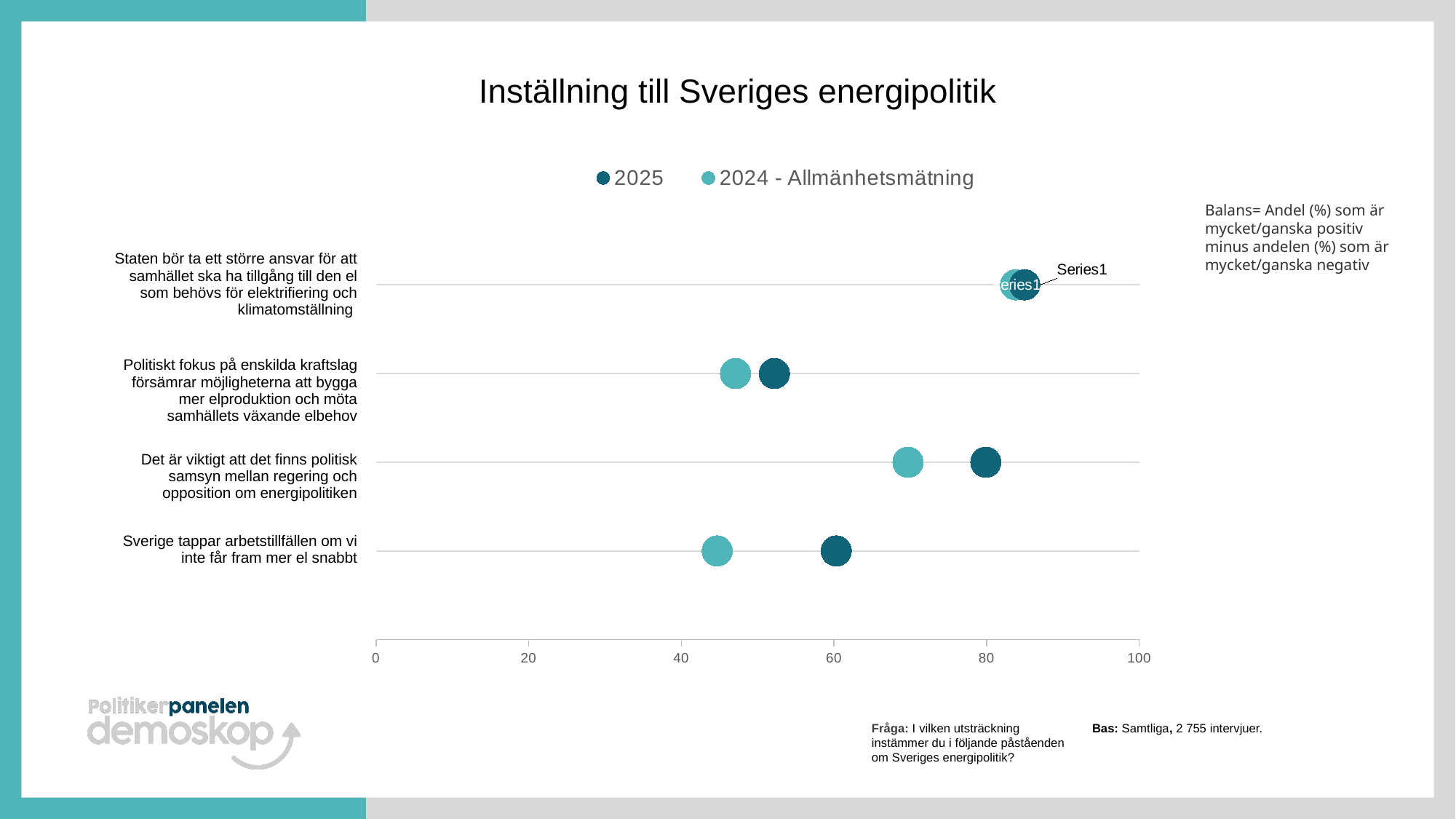
Which statement has the lowest value for the 2025 series? Politiskt fokus på enskilda kraftslag försämrar möjligheterna att bygga mer elproduktion och möta samhällets växande elbehov For 'Sverige tappar arbetstillfällen om vi inte får fram mer el snabbt', which series has the larger value, 2025 or 2024 - Allmänhetsmätning? 2025 How many series does the chart legend list? 2 For 'Det är viktigt att det finns politisk samsyn mellan regering och opposition om energipolitiken', which series has the larger value, 2025 or 2024 - Allmänhetsmätning? 2025 What is the title of the chart? Inställning till Sveriges energipolitik Is the 2025 value for 'Det är viktigt att det finns politisk samsyn mellan regering och opposition om energipolitiken' greater or less than 60? greater How many statements (categories) are plotted on the chart? 4 Is the 2024 - Allmänhetsmätning value for 'Sverige tappar arbetstillfällen om vi inte får fram mer el snabbt' greater or less than 60? less Is the 2025 value for 'Staten bör ta ett större ansvar för att samhället ska ha tillgång till den el som behövs för elektrifiering och klimatomställning' greater or less than 80? greater What kind of chart is shown on the slide? Dot (scatter) chart Which statement has the highest value for the 2024 - Allmänhetsmätning series? Staten bör ta ett större ansvar för att samhället ska ha tillgång till den el som behövs för elektrifiering och klimatomställning